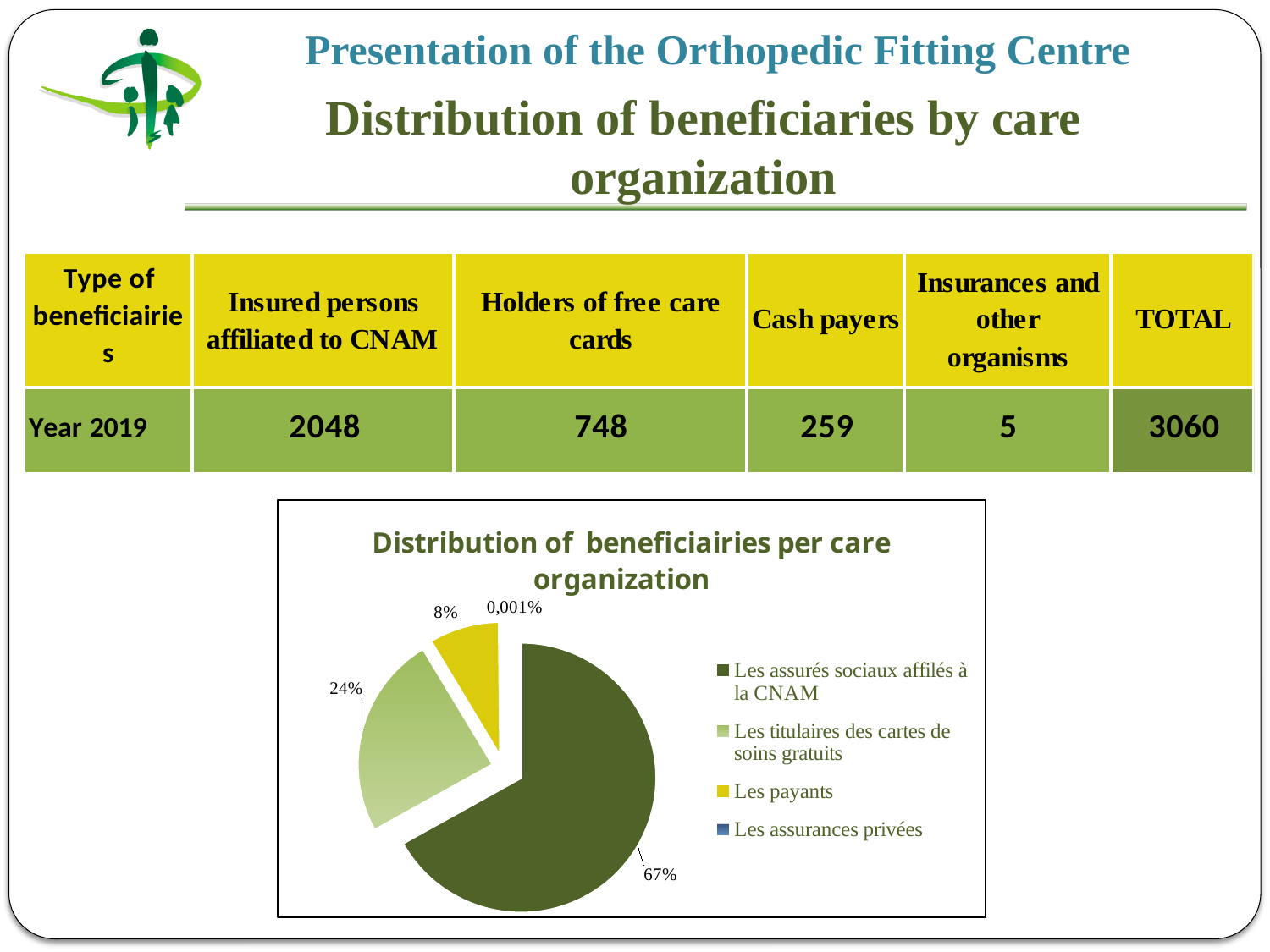
Which slice is larger: 'Les titulaires des cartes de soins gratuits' or 'Les payants'? Les titulaires des cartes de soins gratuits Which category has the smallest slice of the pie? Les assurances privées What is the title of the chart? Distribution of beneficiairies per care organization What share of the pie is labelled for 'Les assurés sociaux affilés à la CNAM'? 67% What kind of chart is shown on the slide? pie chart How many entries does the chart legend list? 4 Which category has the largest slice of the pie? Les assurés sociaux affilés à la CNAM What colour is the slice for 'Les payants'? yellow What share of the pie is labelled for 'Les assurances privées'? 0,001% What share of the pie is labelled for 'Les payants'? 8% What is the difference in percentage points between the 'Les assurés sociaux affilés à la CNAM' slice and the 'Les titulaires des cartes de soins gratuits' slice? 43%